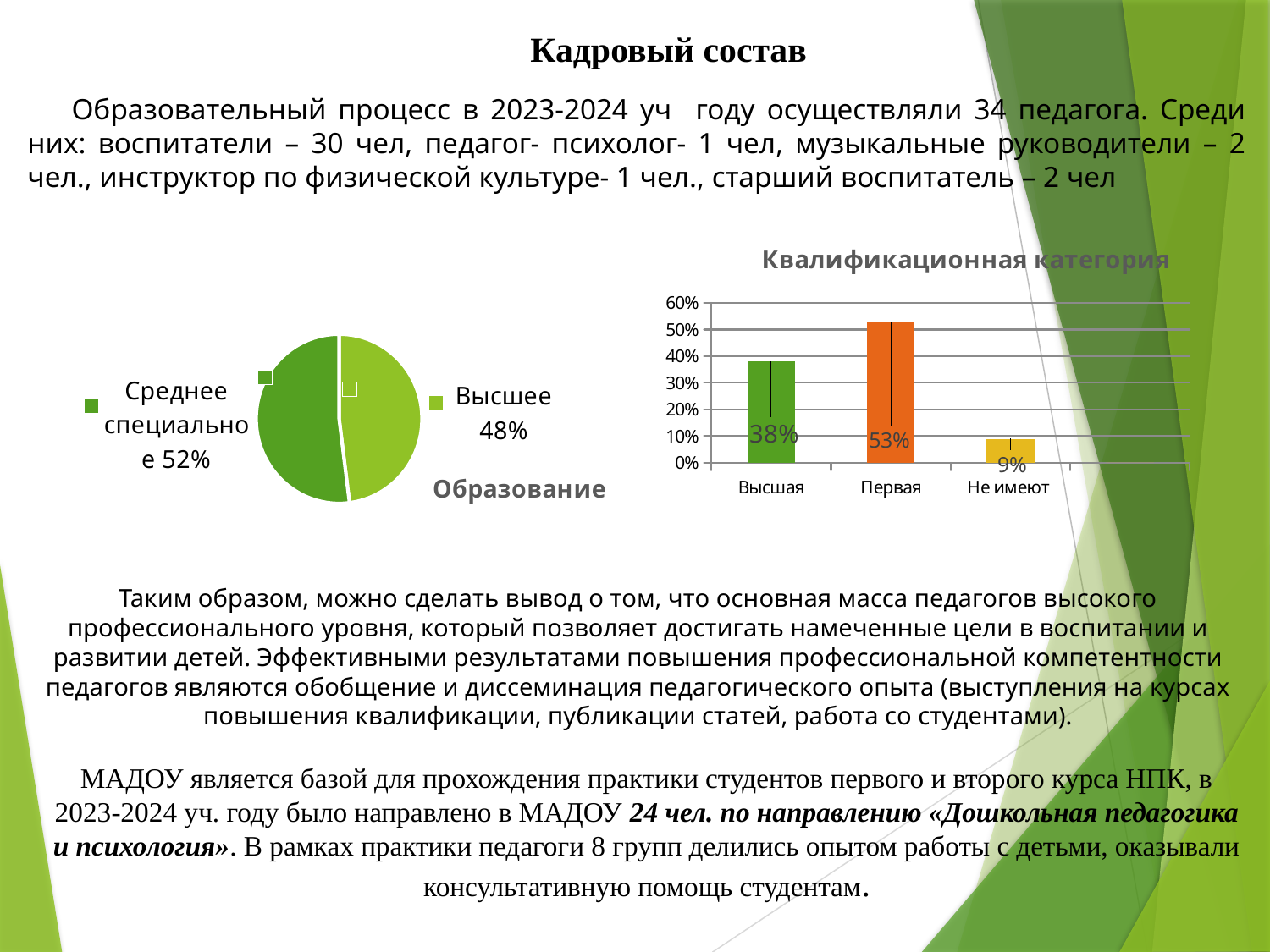
In the 'Квалификационная категория' chart, what is the value for Первая? 53% In the 'Квалификационная категория' chart, what is the value for Высшая? 38% In the 'Квалификационная категория' chart, what is the difference between Первая and Высшая? 15% In the 'Квалификационная категория' chart, which category has the highest value? Первая What kind of chart is the 'Квалификационная категория' chart? bar chart What kind of chart is the 'Образование' chart? pie chart In the 'Образование' chart, what share does Среднее специальное have? 52% In the 'Квалификационная категория' chart, what is the value for Не имеют? 9% In the 'Образование' chart, what share does Высшее have? 48% In the 'Квалификационная категория' chart, which category has the lowest value? Не имеют In the 'Квалификационная категория' chart, how many categories are shown? 3 In the 'Образование' chart, which is larger: Среднее специальное or Высшее? Среднее специальное